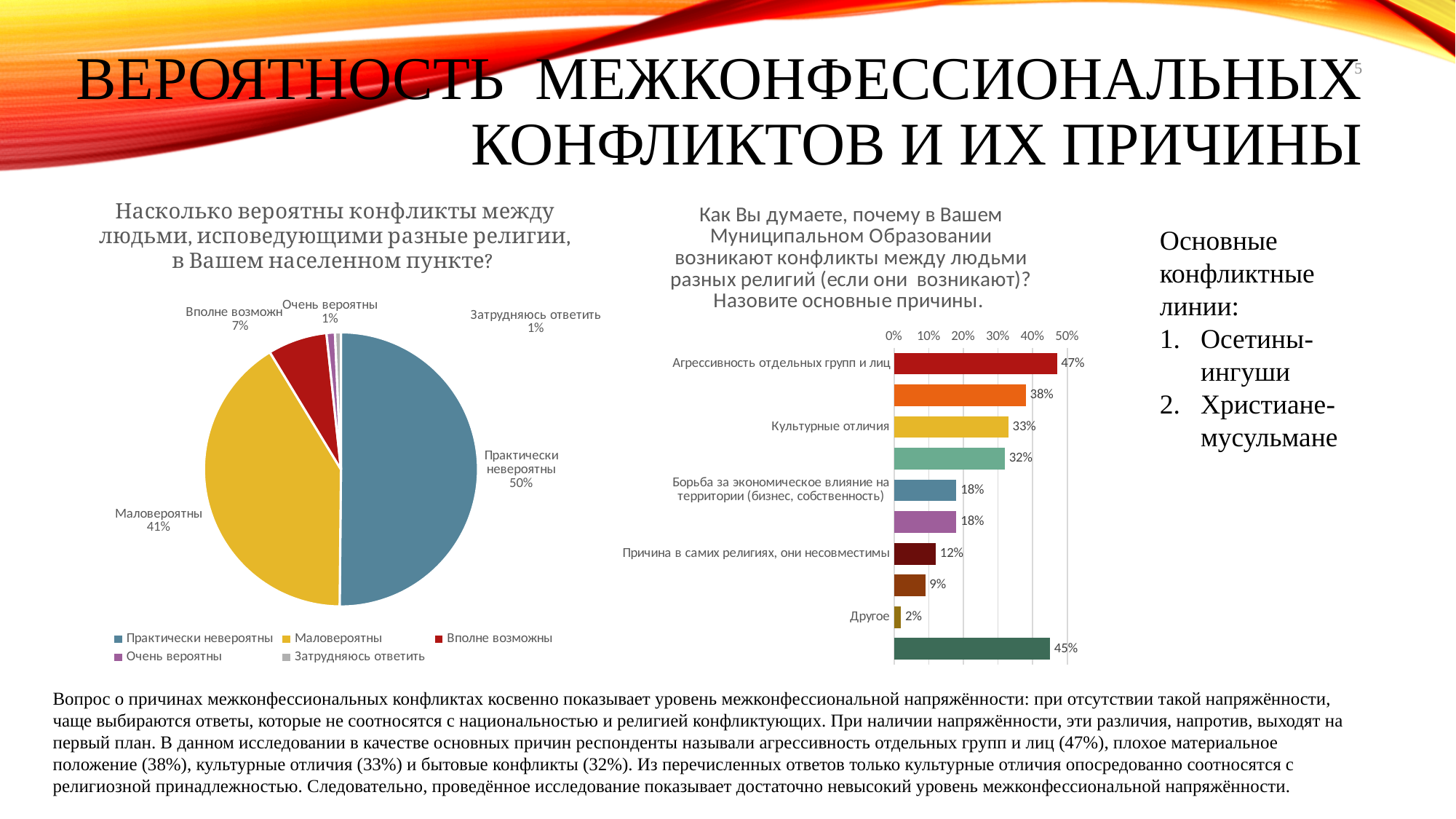
In the bar chart on the right, which category has the lowest value? Другое In the bar chart on the right, which is larger: "Культурные отличия" or "Причина в самих религиях, они несовместимы"? Культурные отличия In the bar chart on the right, how many bars are plotted? 10 In the pie chart on the left, what is the difference between "Практически невероятны" and "Маловероятны"? 9% In the pie chart on the left, what is the value for "Вполне возможны"? 7% In the bar chart on the right, what is the value for "Культурные отличия"? 33% In the pie chart on the left, what is the value for "Маловероятны"? 41% In the pie chart on the left, what share of respondents answered "Практически невероятны"? 50% What kind of chart is the chart on the right about the causes of conflicts? Bar chart In the pie chart on the left, how many entries does the legend list? 5 In the bar chart on the right, what is the value for "Агрессивность отдельных групп и лиц"? 47% In the pie chart on the left, which category has the largest slice? Практически невероятны